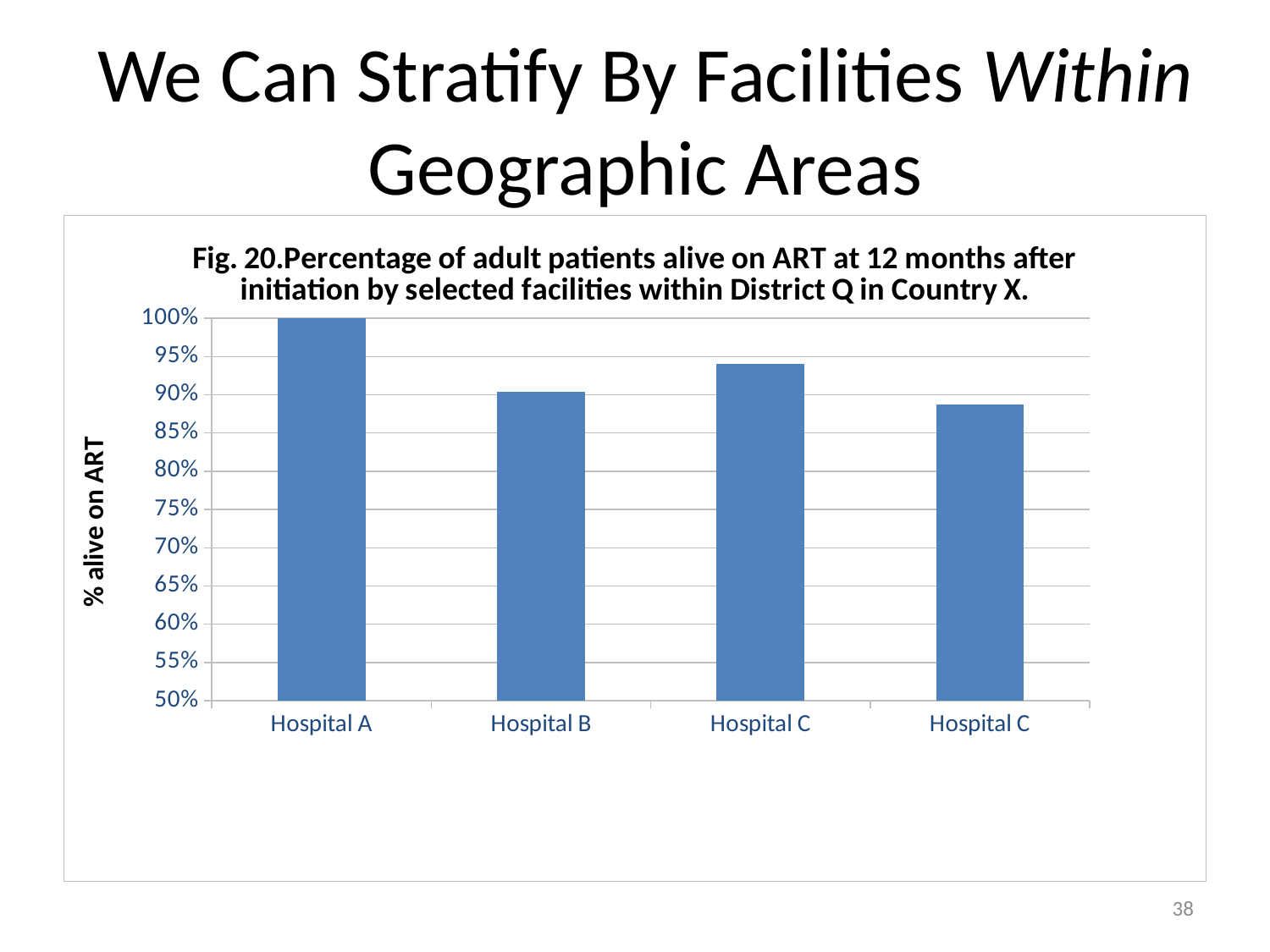
Is the value for Hospital B greater or less than 85%? greater Which bar is the lowest in the chart? the rightmost bar (second Hospital C) What is the percentage alive on ART for Hospital A? 100% How many bars are plotted in the chart? 4 What kind of chart is shown on the slide? bar chart Is the value for the rightmost bar (second Hospital C) greater or less than 90%? less Which facility has the highest percentage alive on ART? Hospital A Which is larger, the value for Hospital A or the value for Hospital B? Hospital A Is the value for the third bar from the left (first Hospital C) greater or less than 90%? greater Which is larger, the third bar from the left (first Hospital C) or Hospital B? the third bar (first Hospital C) What is the title of the vertical axis? % alive on ART